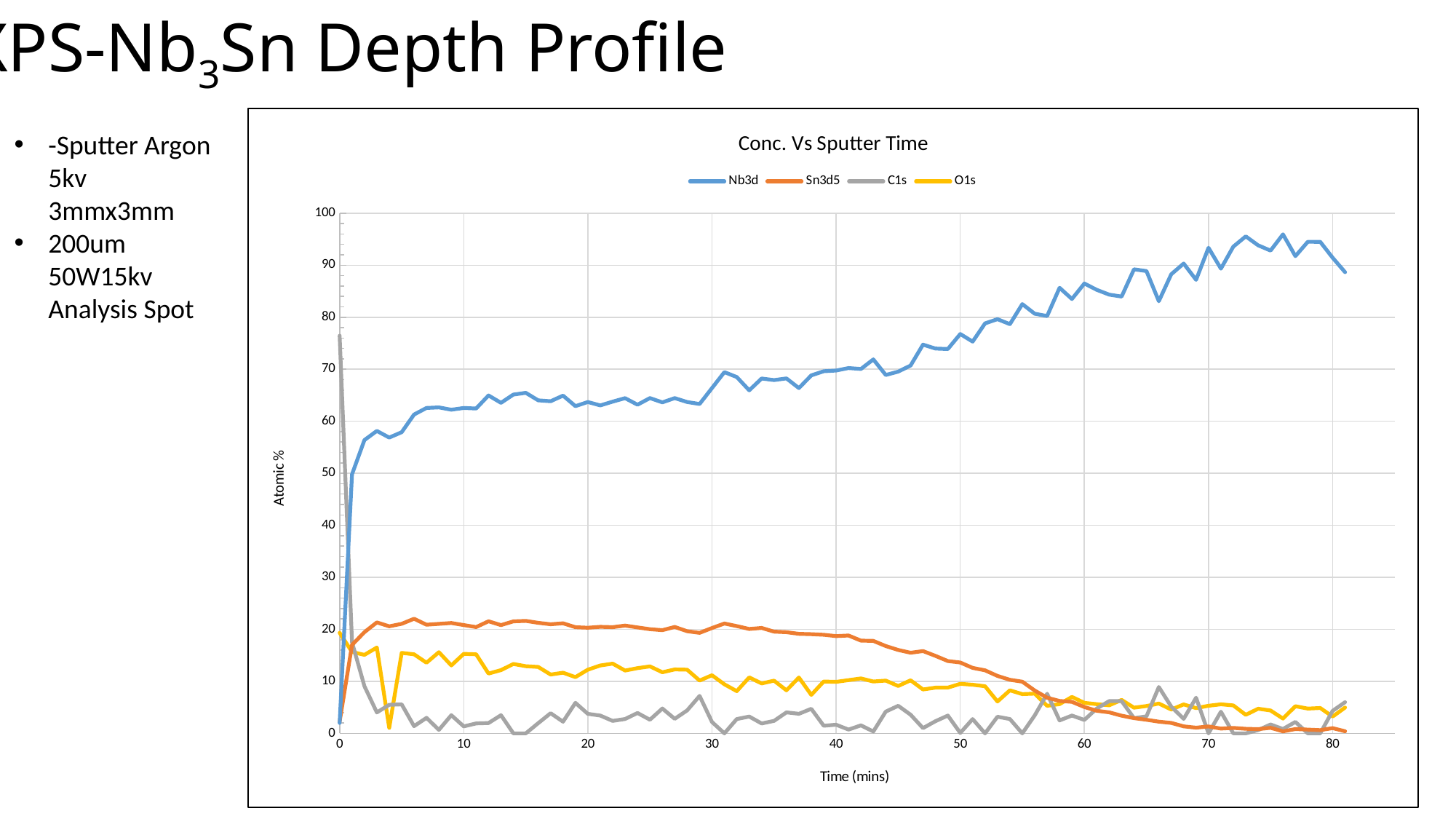
Is the value for Sn3d5 at 80 mins greater or less than 10? less Which series has the highest value at 0 mins? C1s Is the value for Nb3d at 80 mins greater or less than 90? greater Does the Sn3d5 series rise or fall as sputter time increases? fall How many series does the legend of the chart list? 4 Does the Nb3d series rise or fall as sputter time increases? rise What kind of chart is shown on the slide? line chart Is the value for Nb3d at 0 mins greater or less than 10? less At 40 mins, which series has the larger value, Nb3d or Sn3d5? Nb3d What is the label of the y axis of the chart? Atomic % What is the title of the chart? Conc. Vs Sputter Time